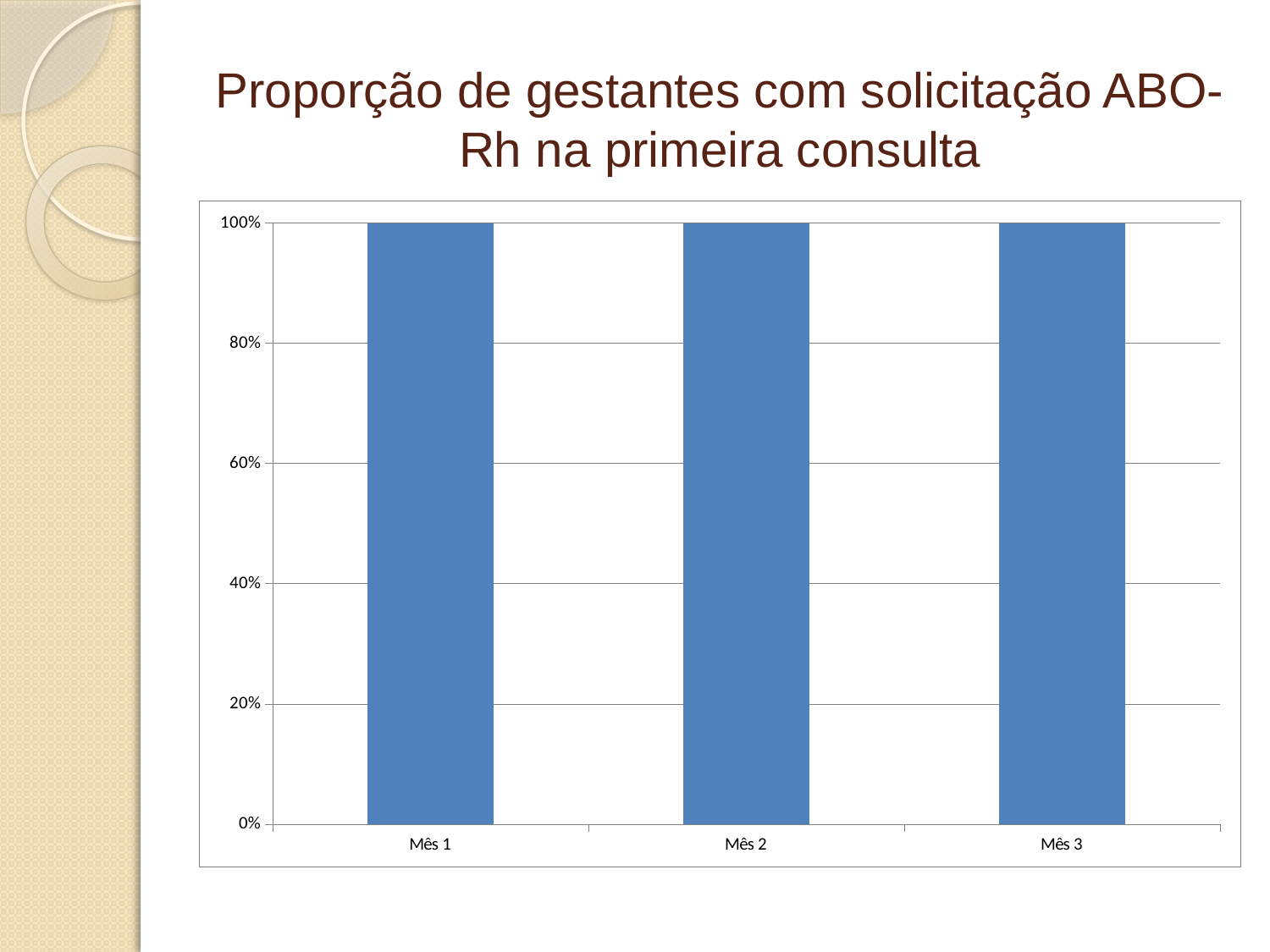
How many categories are plotted on the x axis? 3 Is the value for Mês 2 greater or less than 80%? greater What colour are the bars in the chart? blue What is the difference between the values for Mês 1 and Mês 3? 0% What is the value for Mês 1? 100% What is the value for Mês 3? 100% What is the highest value shown on the y axis? 100% What is the title of the slide containing the chart? Proporção de gestantes com solicitação ABO-Rh na primeira consulta Is the value for Mês 3 greater or less than 60%? greater What kind of chart is shown on the slide? bar chart